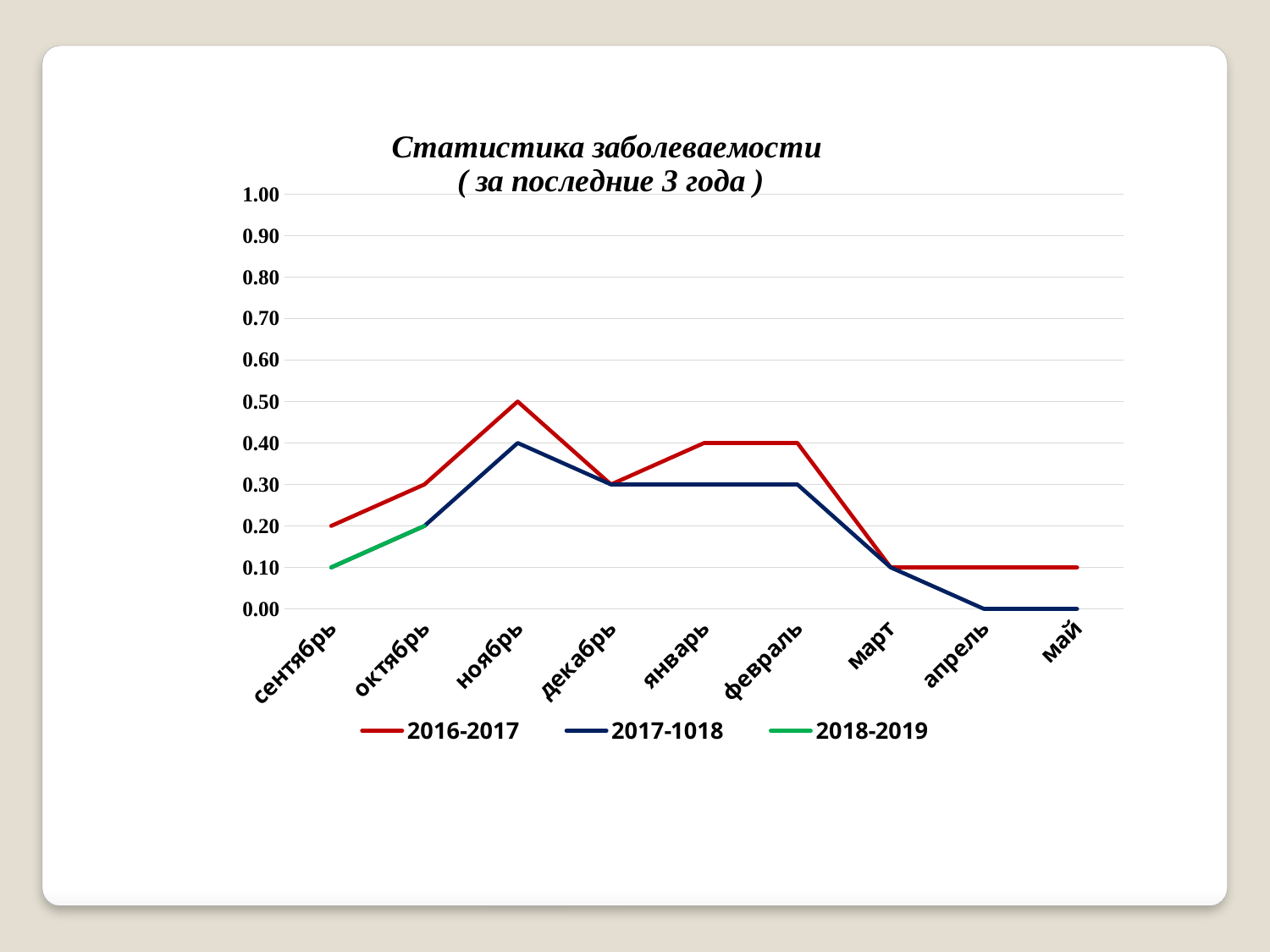
What is the value for the 2018-2019 series in сентябрь? 0.10 What is the value for the 2017-1018 series in ноябрь? 0.40 Does the 2016-2017 series rise or fall from февраль to март? fall How many months are shown on the x axis? 9 What colour is the line for the 2018-2019 series? green What is the difference between the 2016-2017 and 2017-1018 values in февраль? 0.10 What kind of chart is shown on the slide? line chart In which month does the 2016-2017 series reach its highest value? ноябрь How many series does the legend list? 3 What is the value for the 2017-1018 series in апрель? 0.00 What is the value for the 2016-2017 series in ноябрь? 0.50 Which series has the larger value in январь, 2016-2017 or 2017-1018? 2016-2017